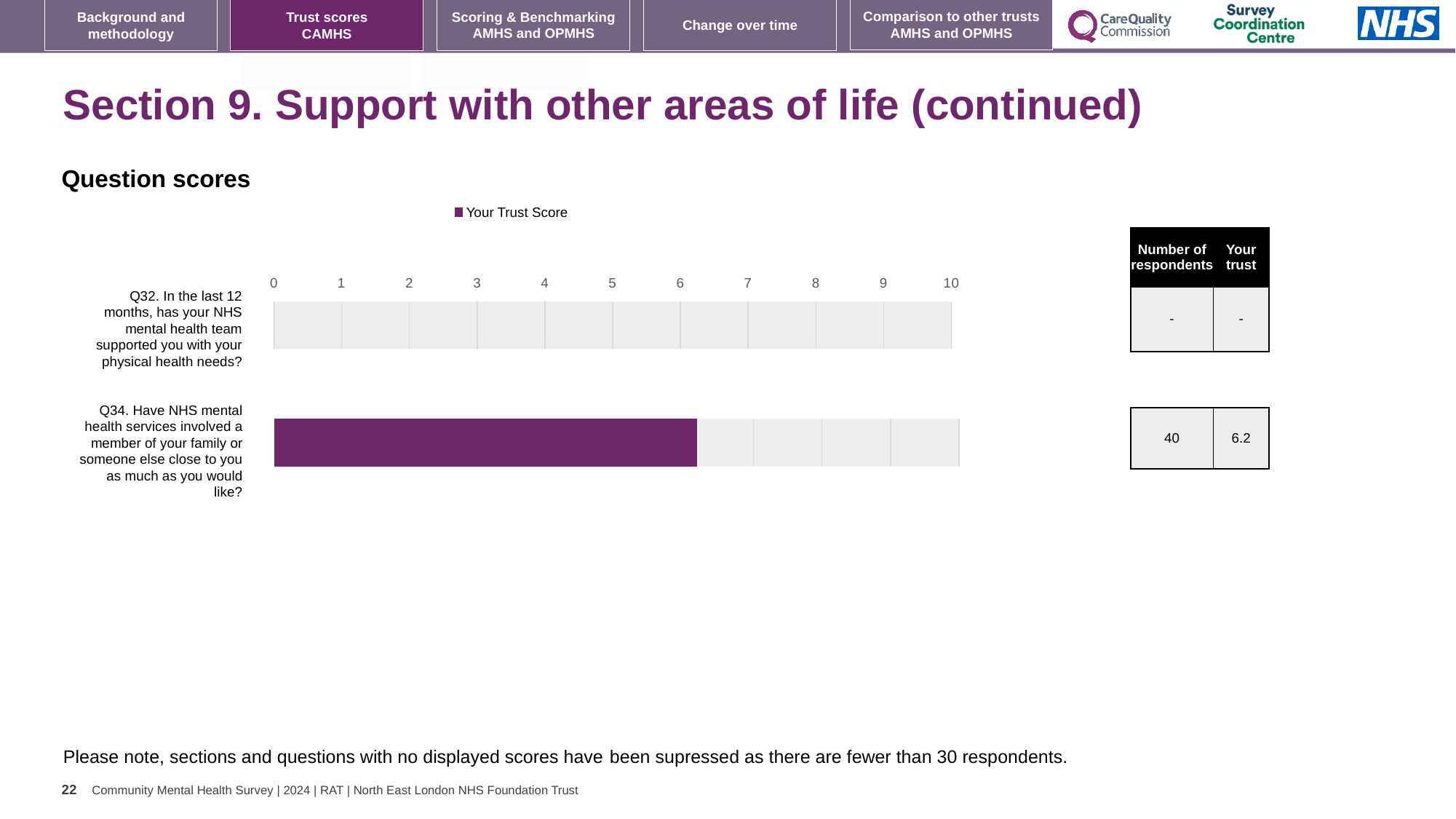
What is the series name shown in the chart legend? Your Trust Score Which question on the chart has no displayed score? Q32 How many respondents answered Q34? 40 Is the trust score for Q34 greater or less than 8? less What kind of chart is shown under 'Question scores'? Bar chart What is the maximum value shown on the chart's axis? 10 How many questions (categories) are shown on the chart? 2 What is shown in the 'Your trust' column for Q32? - Is the trust score for Q34 greater or less than 5? greater What is the trust score for Q34 (Have NHS mental health services involved a member of your family or someone else close to you as much as you would like?)? 6.2 How many series does the legend list? 1